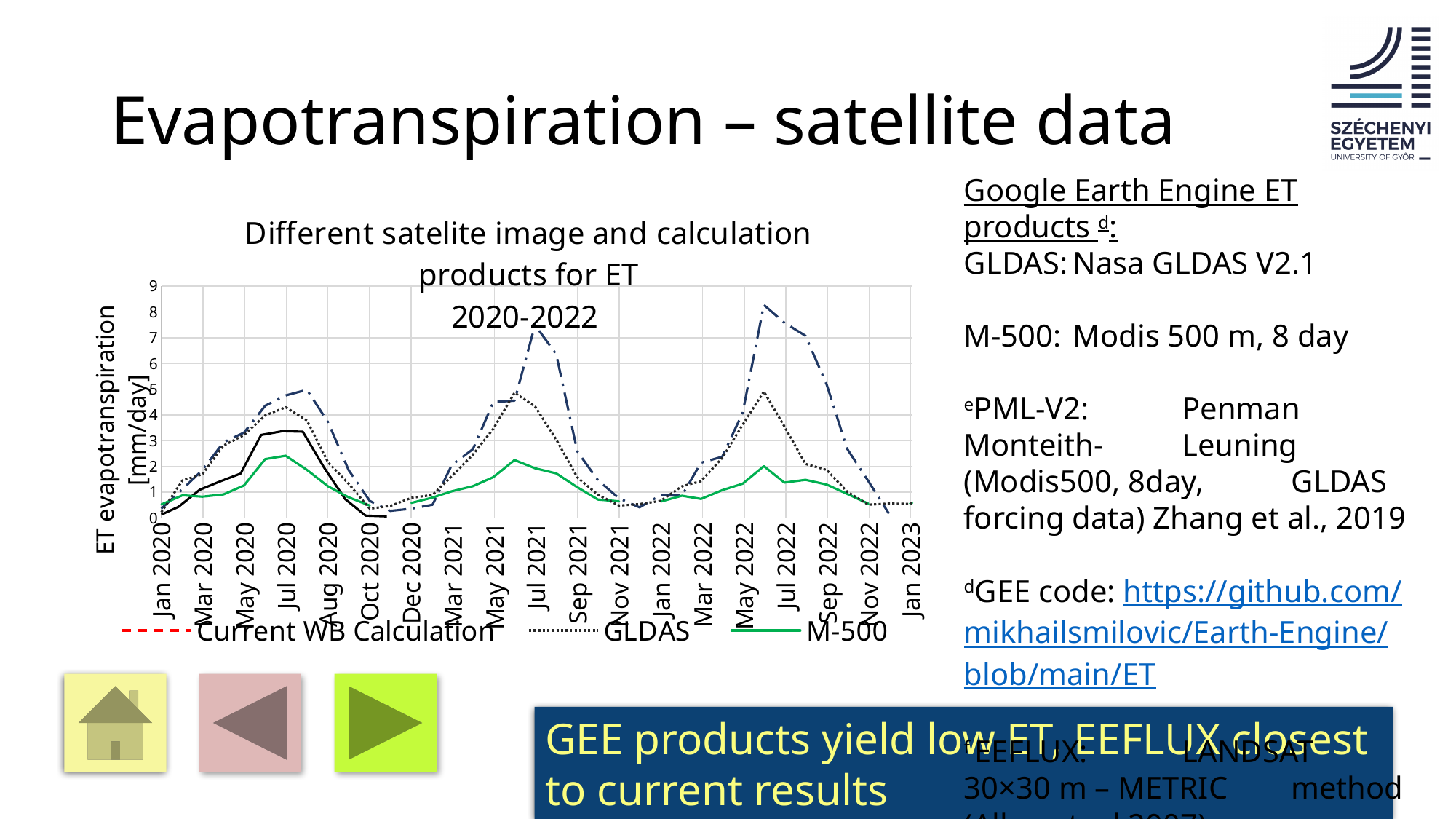
Which series is higher in Jul 2021, GLDAS or M-500? GLDAS Does the GLDAS series rise or fall between Jul 2021 and Nov 2021? fall Is the value of the GLDAS series in Jan 2022 greater or less than 2? less Is the value of the M-500 series in Jul 2021 greater or less than 3? less What kind of chart is shown on the slide? line chart Is the peak value of the M-500 series in mid-2020 greater or less than 3? less What is the title of the chart? Different satelite image and calculation products for ET 2020-2022 What is the label of the vertical axis of the chart? ET evapotranspiration [mm/day] Does the M-500 series rise or fall between Jan 2020 and Jul 2020? rise How many series does the chart legend list? 3 What is the highest tick value shown on the vertical axis? 9